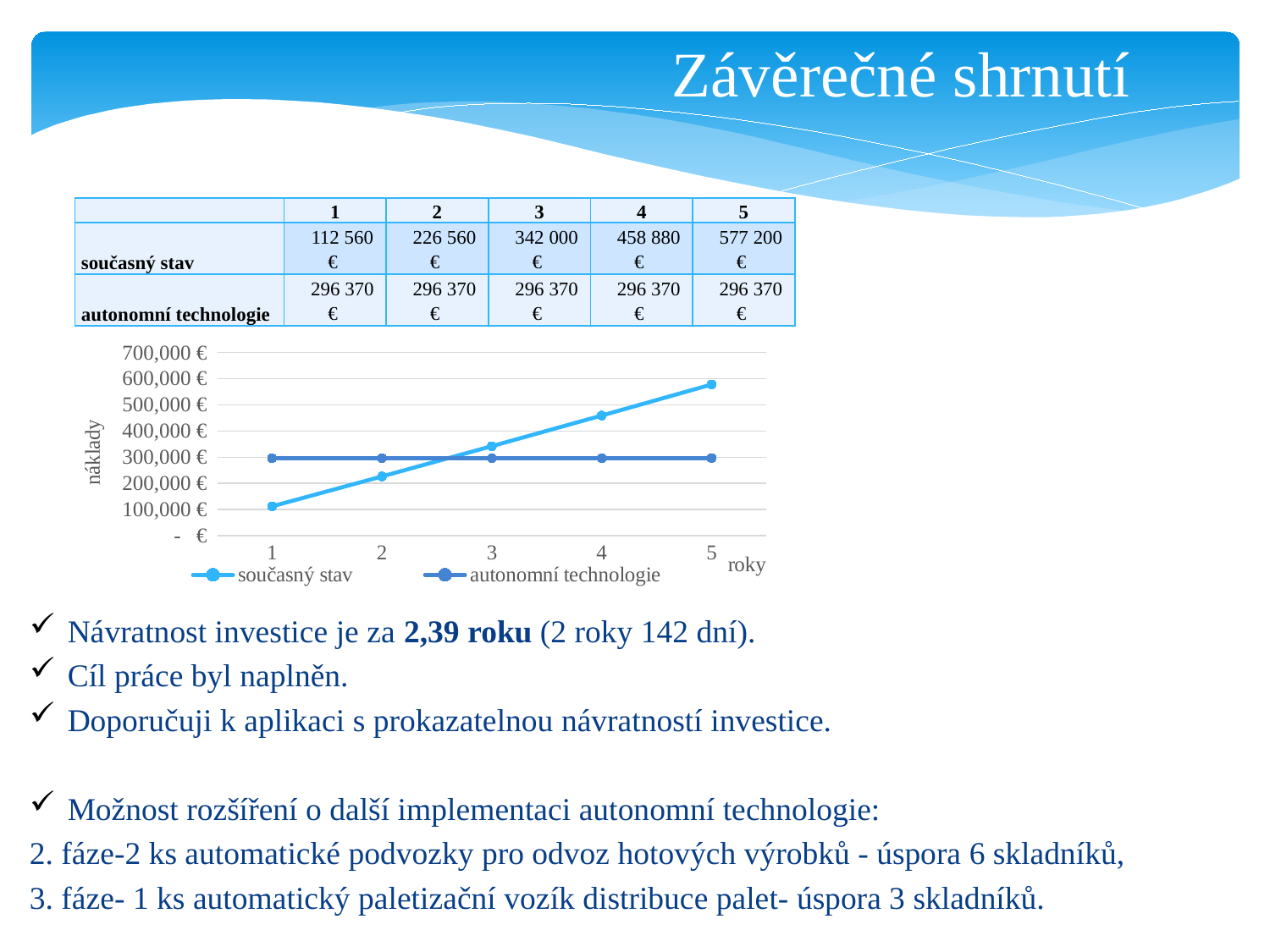
How many series does the chart legend list? 2 In year 5, which series has the larger value, 'současný stav' or 'autonomní technologie'? současný stav What is the label of the vertical axis of the chart? náklady Do the values for 'autonomní technologie' change across the years? No, they stay constant What is the difference between 'současný stav' and 'autonomní technologie' in year 5? 280 830 € In year 1, which series has the larger value, 'současný stav' or 'autonomní technologie'? autonomní technologie What is the value of 'autonomní technologie' in year 3? 296 370 € How many points (years) are plotted along the x axis of the chart? 5 What is the value of 'současný stav' in year 5? 577 200 € What kind of chart is shown on the slide? line chart Do the values for 'současný stav' rise or fall from year 1 to year 5? rise Is the value for 'současný stav' in year 4 greater or less than 400,000 €? greater